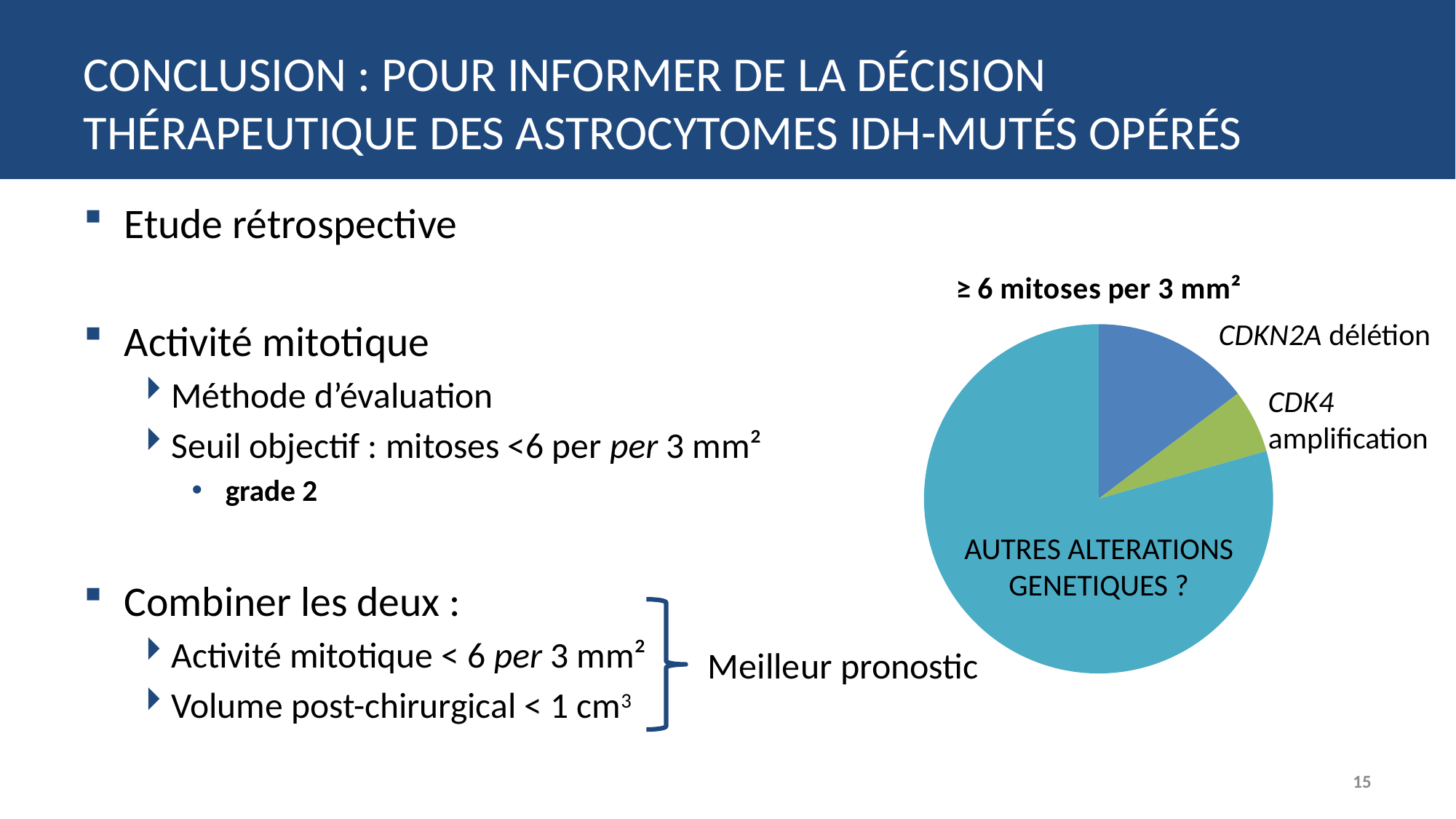
How many slices does the pie chart have? 3 What kind of chart is shown on the slide? pie chart What is the title of the pie chart? ≥ 6 mitoses per 3 mm² Which slice is larger in the pie chart, CDKN2A délétion or CDK4 amplification? CDKN2A délétion What colour is the CDK4 amplification slice in the pie chart? green Which slice of the pie chart is the smallest? CDK4 amplification Which slice is larger in the pie chart, AUTRES ALTERATIONS GENETIQUES ? or CDKN2A délétion? AUTRES ALTERATIONS GENETIQUES ? Which slice of the pie chart is the largest? AUTRES ALTERATIONS GENETIQUES ?